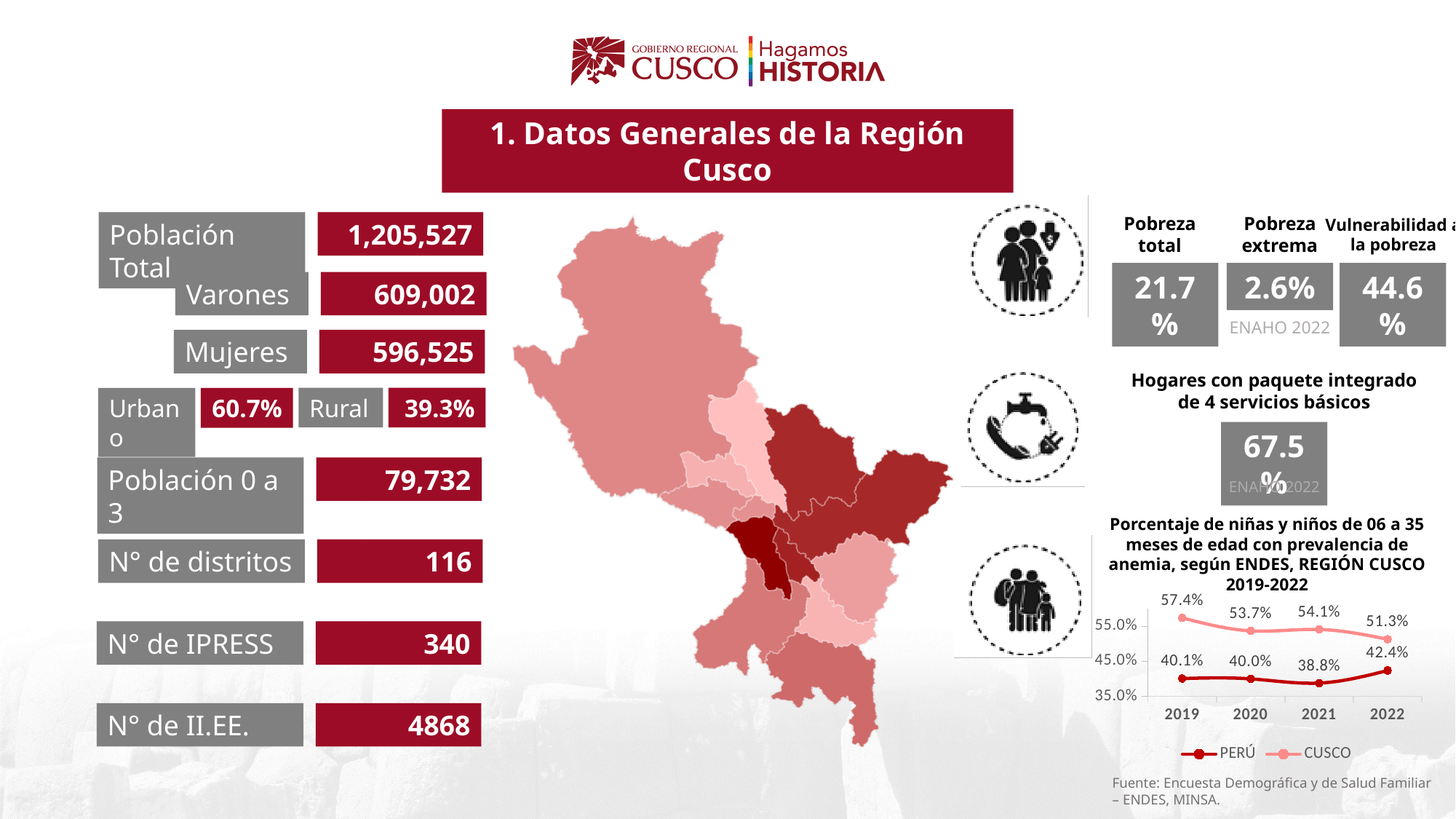
In the anemia chart, what is the value for PERÚ in 2021? 38.8% How many years are shown on the x axis of the anemia chart? 4 In the anemia chart, what is the value for CUSCO in 2019? 57.4% In the anemia chart, which year has the highest value for CUSCO? 2019 In the anemia chart, what is the value for CUSCO in 2022? 51.3% In the anemia chart, does the CUSCO series generally rise or fall from 2019 to 2022? fall In the anemia chart, which series has the larger value in 2020, PERÚ or CUSCO? CUSCO In the anemia chart, what is the difference between the CUSCO and PERÚ values in 2019? 17.3% In the anemia chart, which year has the lowest value for PERÚ? 2021 In the anemia chart, what is the value for PERÚ in 2022? 42.4% What type of chart is used to show the percentage of children aged 06 to 35 months with anemia? line chart How many series does the legend of the anemia chart list? 2